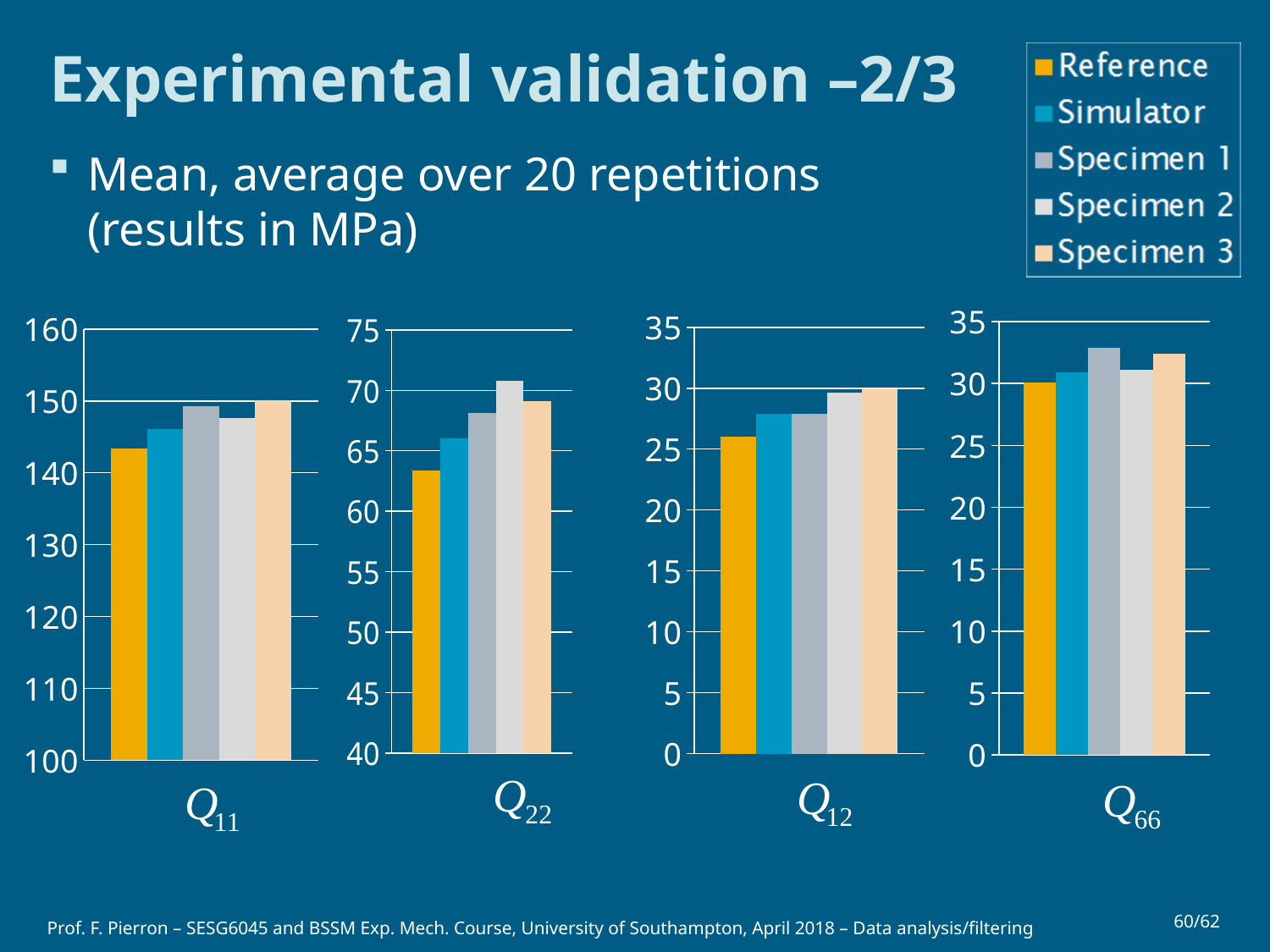
In the Q22 chart, is the value for Specimen 2 greater or less than 65? greater In the Q66 chart, is the value for Specimen 1 greater or less than 30? greater In the Q12 chart, is the value for Reference greater or less than 30? less Which legend entry is shown in orange/gold? Reference How many series does the legend list? 5 How many separate charts are shown on the slide? 4 In the Q22 chart, which series has the highest value? Specimen 2 In the Q12 chart, which is larger, the value for Specimen 3 or the value for Reference? Specimen 3 What kind of chart is used for Q11 on this slide? bar chart In the Q11 chart, which series has the lowest value? Reference